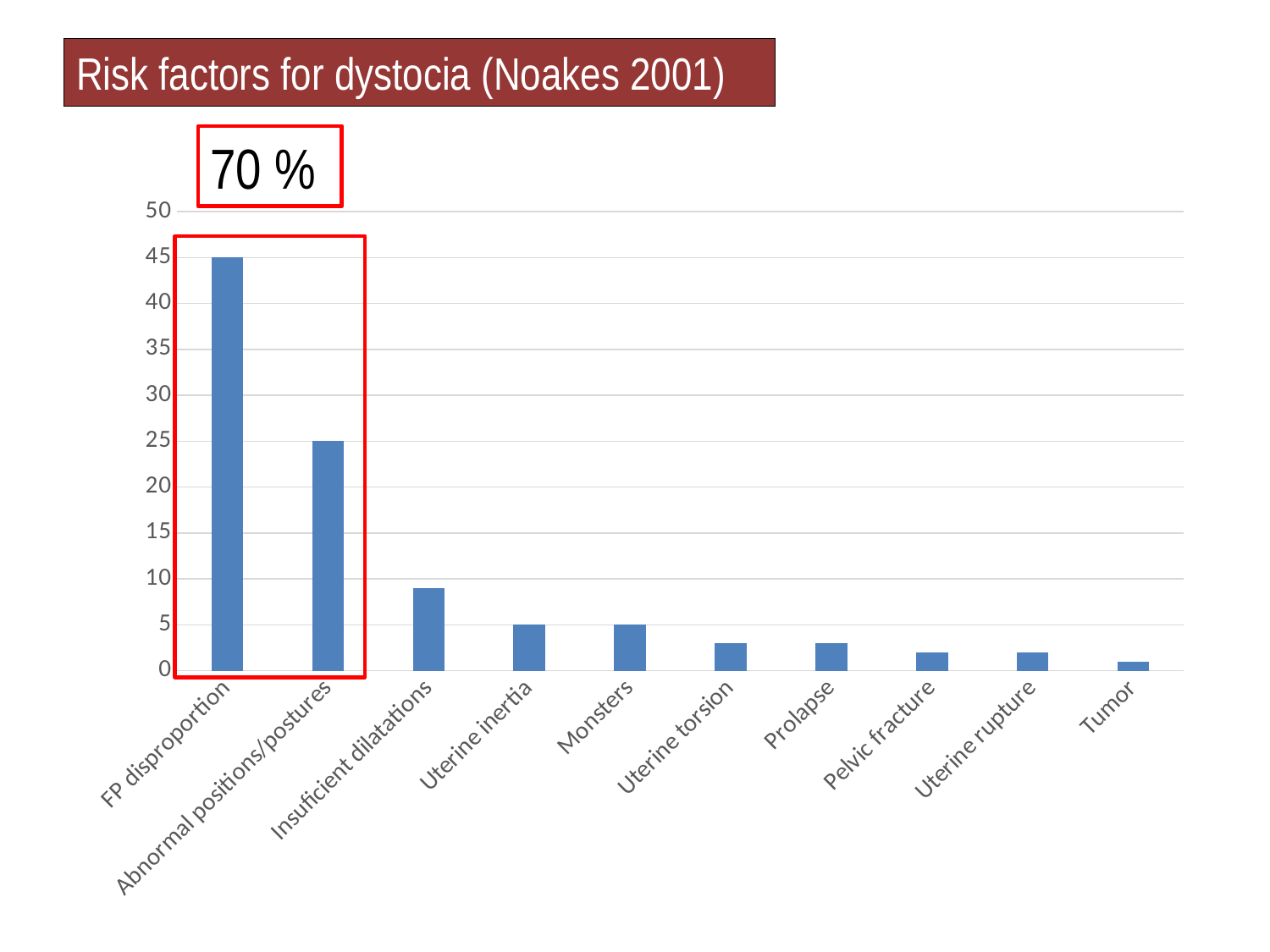
Is the value for Insufficient dilatations greater or less than 10? less What kind of chart is shown on the slide? bar chart Which is larger, the value for Abnormal positions/postures or the value for Insufficient dilatations? Abnormal positions/postures What is the title of the slide containing the chart? Risk factors for dystocia (Noakes 2001) Which category has the highest value in the chart? FP disproportion What is the value for Abnormal positions/postures? 25 Which category has the lowest value in the chart? Tumor What is the value for Uterine inertia? 5 How many categories are plotted on the x axis of the chart? 10 Do the values rise or fall moving left to right along the x axis? fall What is the value for FP disproportion? 45 What is the difference between the values for FP disproportion and Abnormal positions/postures? 20